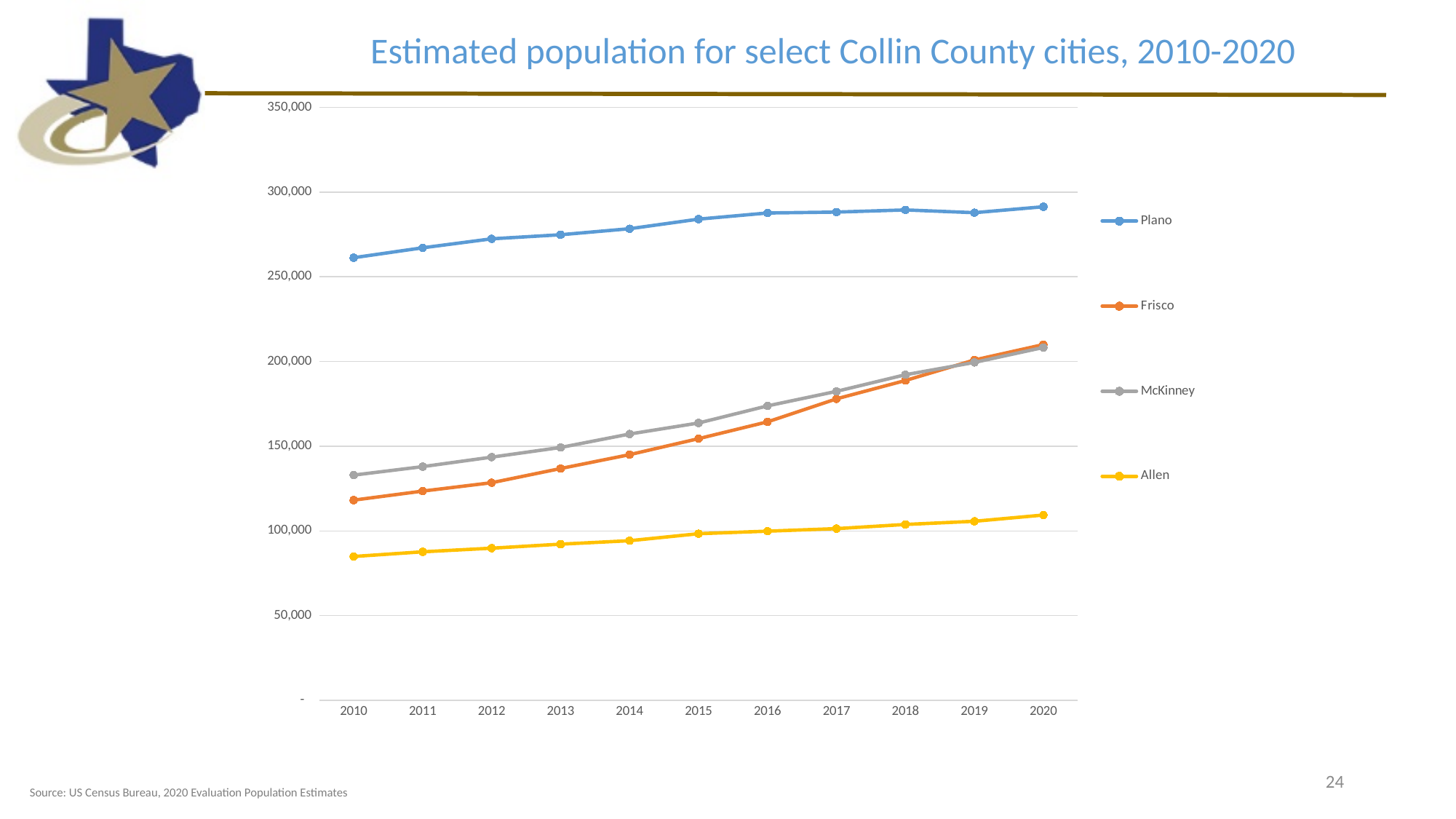
Is the value for Plano in 2010 greater or less than 250,000? greater Is the value for Allen in 2010 greater or less than 100,000? less What kind of chart is shown on the slide? Line chart Is the value for Plano in 2020 greater or less than 300,000? less Does the estimated population for Allen rise or fall from 2010 to 2020? Rise What is the title of the chart? Estimated population for select Collin County cities, 2010-2020 Which city has the lowest estimated population in 2010? Allen Which is larger in 2010, the value for McKinney or the value for Frisco? McKinney How many years are plotted along the x axis? 11 How many series does the legend list? 4 Which city has the highest estimated population in 2020? Plano